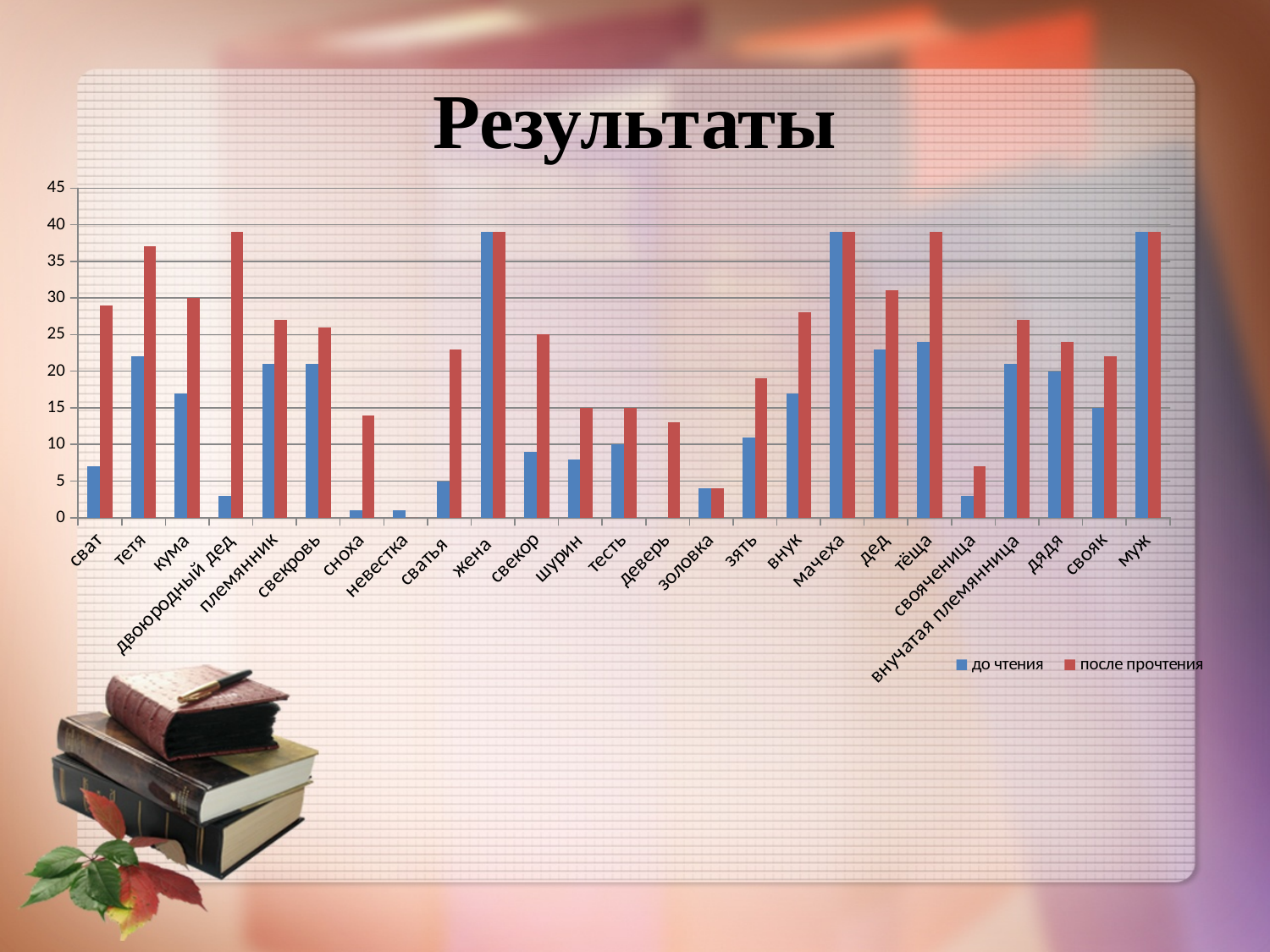
Is the value for тетя in the series после прочтения greater or less than 35? greater How many categories are shown on the x axis? 25 For внук, which series has the larger value: до чтения or после прочтения? после прочтения Is the value for двоюродный дед in the series до чтения greater or less than 5? less How many series does the legend list? 2 For сват, which series has the larger value: до чтения or после прочтения? после прочтения Is the value for свояченица in the series после прочтения greater or less than 10? less Which series is shown in blue? до чтения What kind of chart is shown on the slide? bar chart What is the title of the chart? Результаты